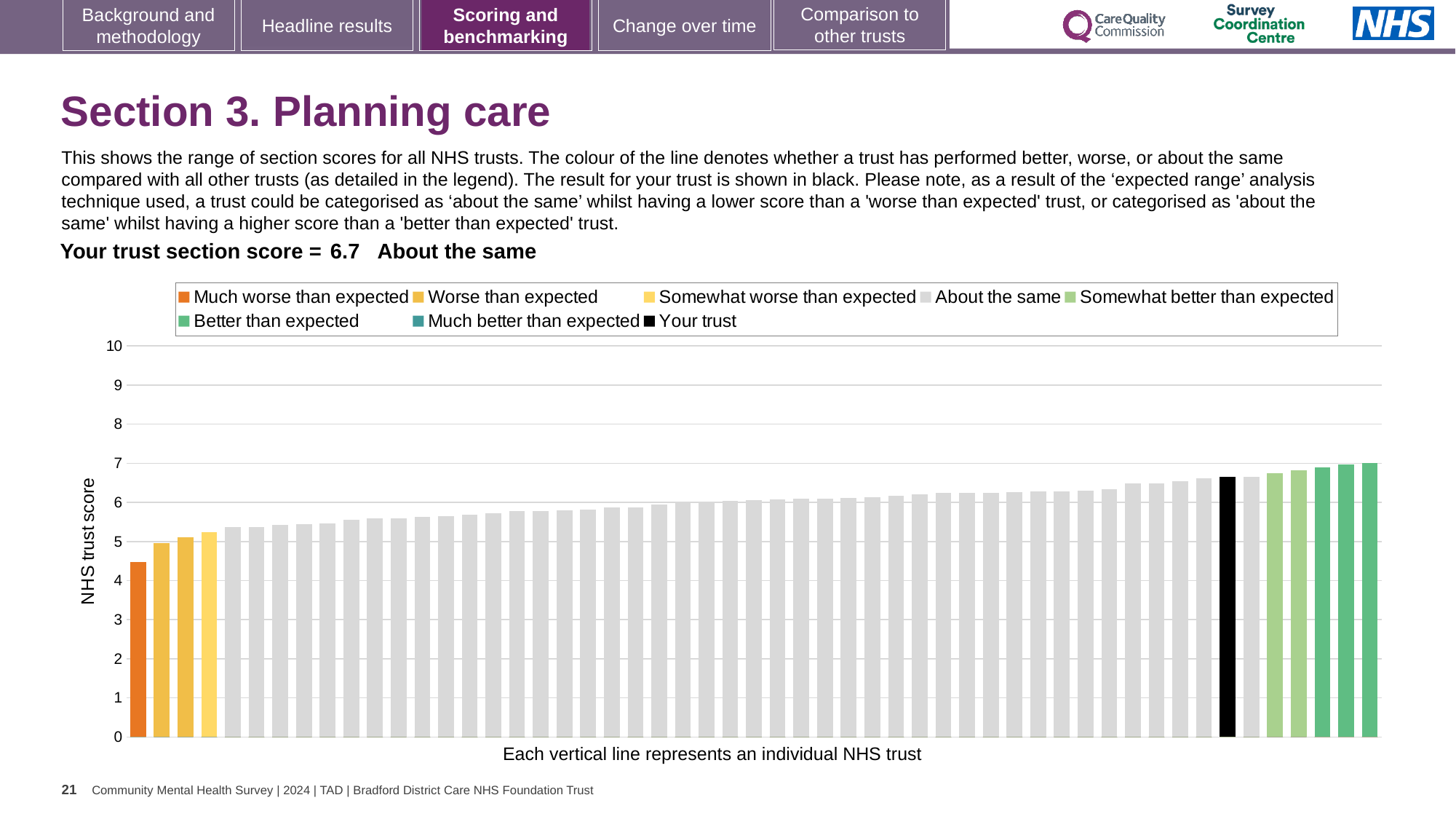
What kind of chart is shown on the slide? bar chart What is the label on the vertical axis of the chart? NHS trust score What is the section score for your trust shown on the slide? 6.7 Which category is your trust placed in for the Planning care section score? About the same How many bars are coloured orange for 'Much worse than expected'? 1 Is the value for the black 'Your trust' bar greater or less than 6? greater Do the NHS trust scores rise or fall from left to right along the x axis? rise Is the value for the leftmost (orange) bar greater or less than 5? less How many entries does the chart legend list? 8 Is the value for the leftmost (orange) bar greater or less than 4? greater Which bar is lowest on the chart: the orange 'Much worse than expected' bar or the black 'Your trust' bar? the orange 'Much worse than expected' bar What colour is used in the chart to show your trust? black